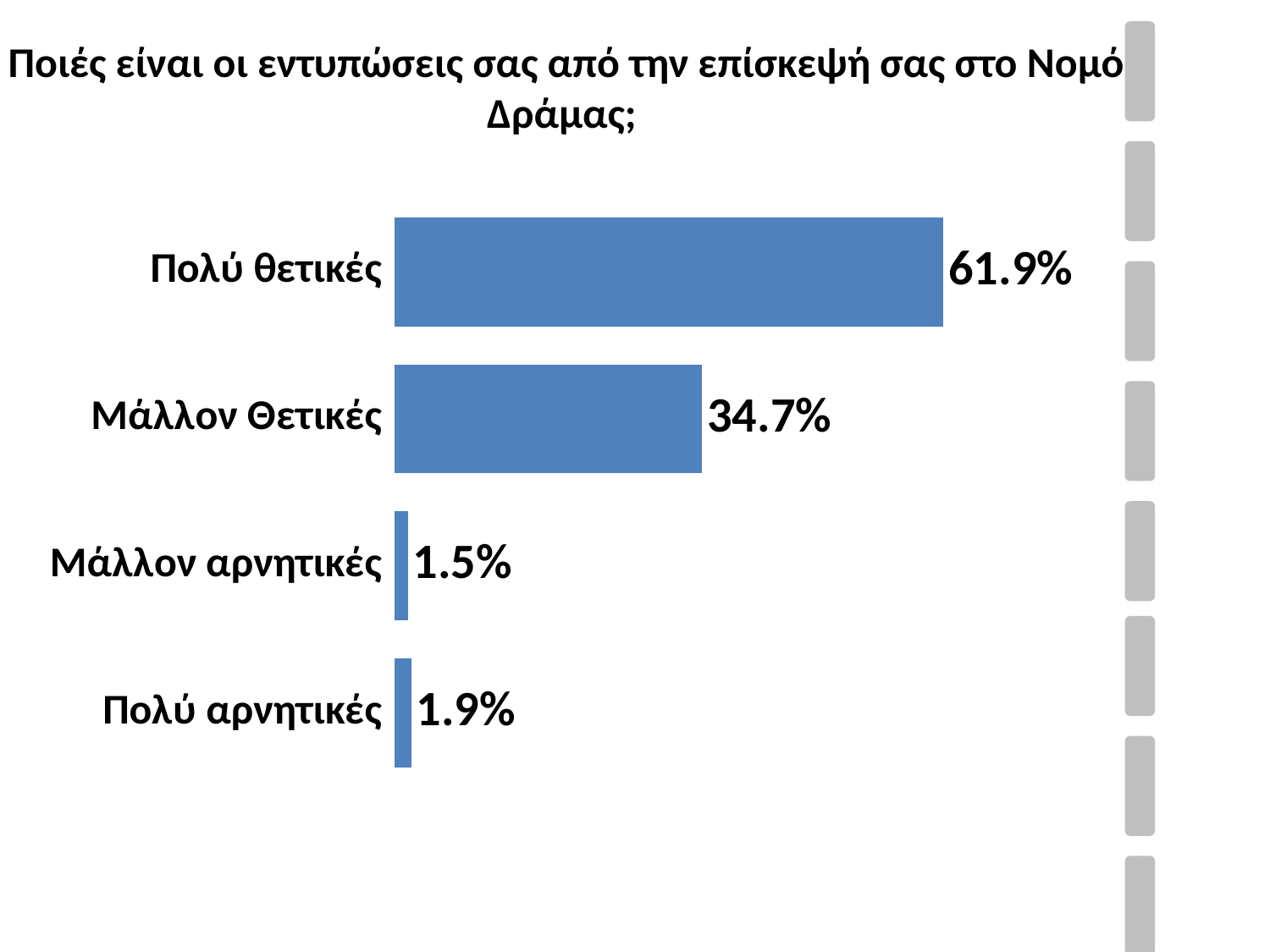
What is the value for Πολύ θετικές? 61.9% Which is larger, the value for Πολύ αρνητικές or the value for Μάλλον αρνητικές? Πολύ αρνητικές How many categories are shown in the chart? 4 What is the value for Μάλλον Θετικές? 34.7% Which category has the lowest value? Μάλλον αρνητικές What is the title of the chart? Ποιές είναι οι εντυπώσεις σας από την επίσκεψή σας στο Νομό Δράμας; What is the value for Πολύ αρνητικές? 1.9% What colour are the bars in the chart? Blue What is the difference between the values for Πολύ θετικές and Μάλλον Θετικές? 27.2% What kind of chart is shown on the slide? Bar chart What is the value for Μάλλον αρνητικές? 1.5% Which category has the highest value? Πολύ θετικές